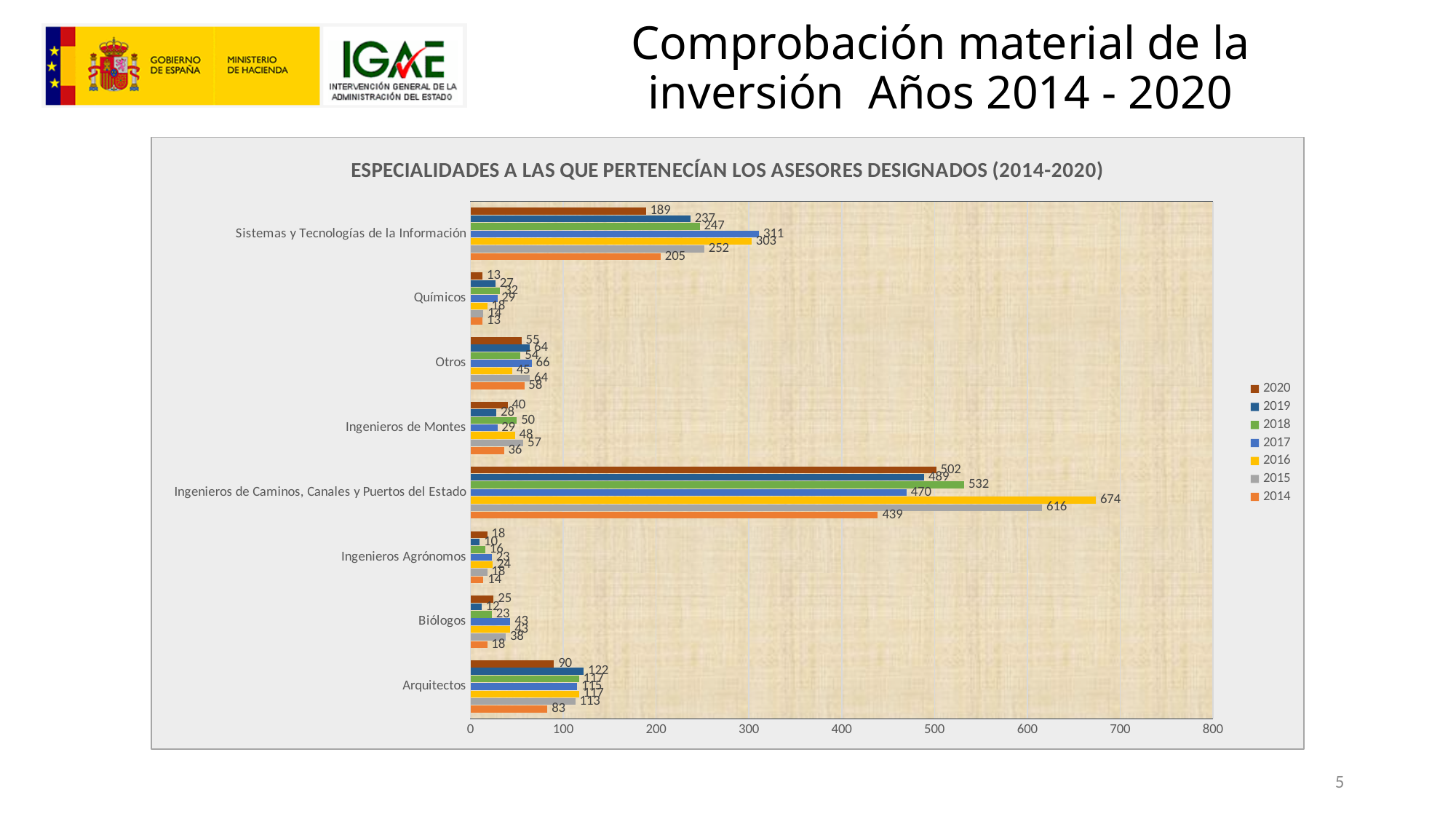
What is the value for Sistemas y Tecnologías de la Información in 2017? 311 What is the value for Ingenieros de Montes in 2015? 57 What is the value for Ingenieros de Caminos, Canales y Puertos del Estado in 2016? 674 What is the difference between the 2018 and 2017 values for Ingenieros de Caminos, Canales y Puertos del Estado? 62 How many series does the legend list? 7 What type of chart is shown on the slide? bar chart Which year has the lowest value for Ingenieros de Caminos, Canales y Puertos del Estado? 2014 What is the title of the chart? ESPECIALIDADES A LAS QUE PERTENECÍAN LOS ASESORES DESIGNADOS (2014-2020) What is the value for Arquitectos in 2014? 83 How many specialty categories are shown on the chart? 8 Which is larger for Sistemas y Tecnologías de la Información: the 2016 value or the 2015 value? 2016 Which category has the highest value in 2020? Ingenieros de Caminos, Canales y Puertos del Estado